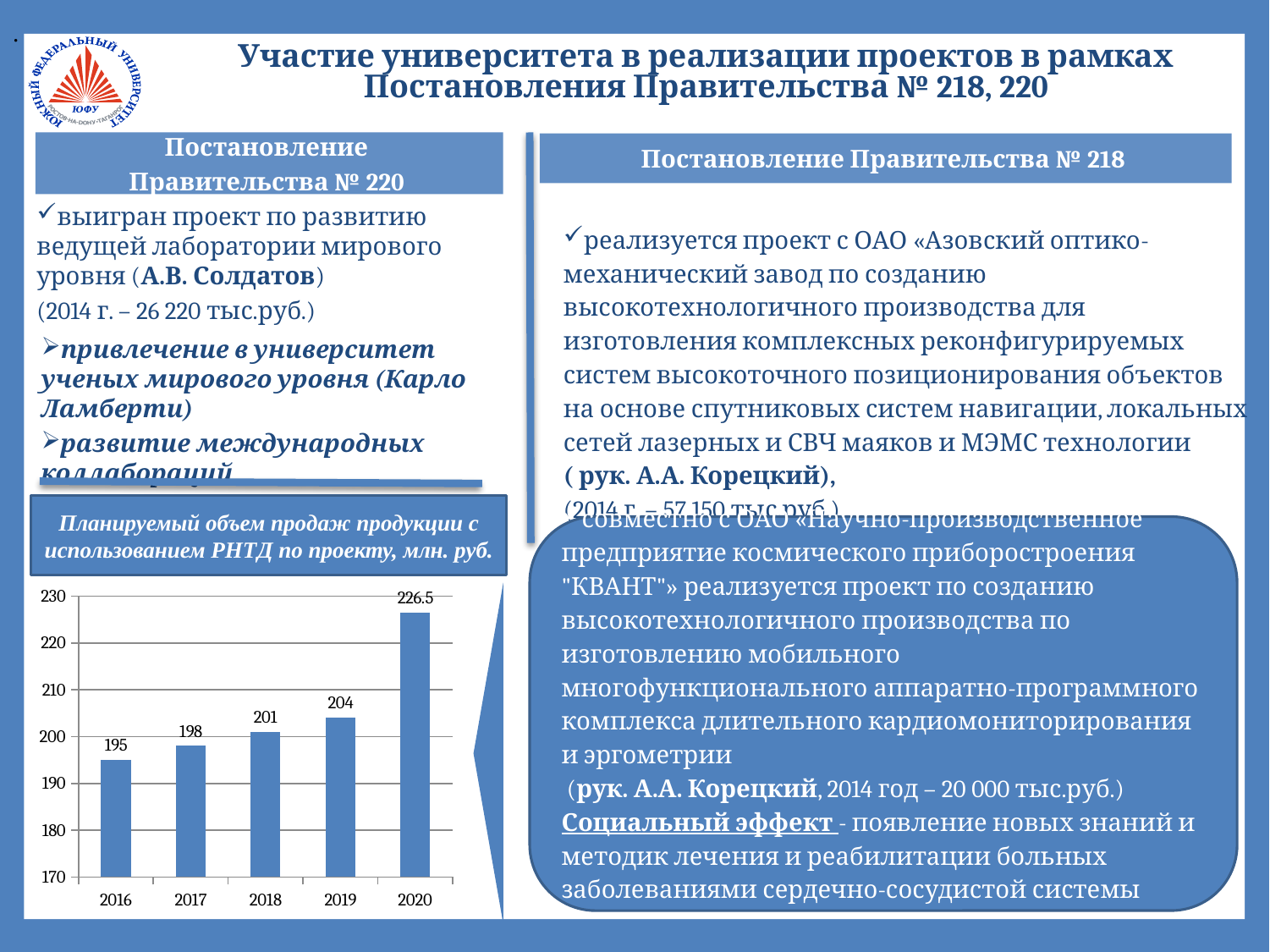
Which year has a larger planned sales volume, 2018 or 2019? 2019 What is the difference between the planned sales volume in 2020 and in 2019? 22.5 What is the planned sales volume for 2016? 195 Which year has the lowest planned sales volume? 2016 Do the planned sales volumes rise or fall from 2016 to 2020? rise What is the planned sales volume for 2018? 201 What is the planned sales volume for 2020? 226.5 What is the difference between the planned sales volume in 2017 and in 2016? 3 How many years are shown on the chart? 5 Is the planned sales volume for 2019 greater or less than 210? less What type of chart is used to show the planned sales volume? bar chart Which year has the highest planned sales volume? 2020